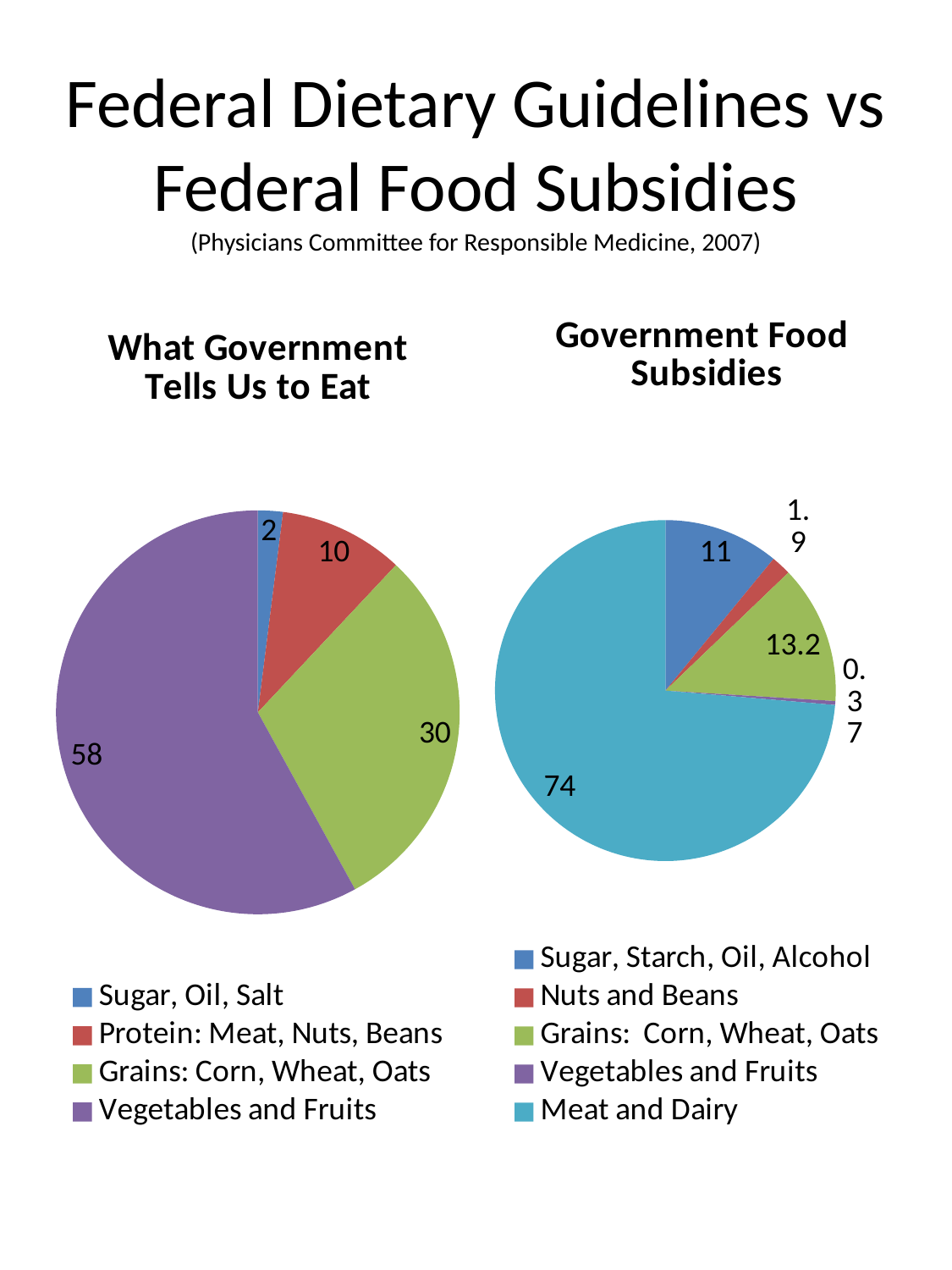
In the "Government Food Subsidies" chart, what is the value for Nuts and Beans? 1.9 How many categories does the "What Government Tells Us to Eat" chart have? 4 In the "What Government Tells Us to Eat" chart, what is the value for Vegetables and Fruits? 58 In the "Government Food Subsidies" chart, what is the value for Grains: Corn, Wheat, Oats? 13.2 In the "Government Food Subsidies" chart, which category has the largest slice? Meat and Dairy In the "What Government Tells Us to Eat" chart, what is the value for Grains: Corn, Wheat, Oats? 30 In the "Government Food Subsidies" chart, what is the value for Meat and Dairy? 74 In the "Government Food Subsidies" chart, which is larger: Sugar, Starch, Oil, Alcohol or Grains: Corn, Wheat, Oats? Grains: Corn, Wheat, Oats What type of chart is used for "What Government Tells Us to Eat"? pie chart In the "What Government Tells Us to Eat" chart, what is the difference between Vegetables and Fruits and Grains: Corn, Wheat, Oats? 28 In the "What Government Tells Us to Eat" chart, which category has the smallest slice? Sugar, Oil, Salt How many categories does the legend of the "Government Food Subsidies" chart list? 5